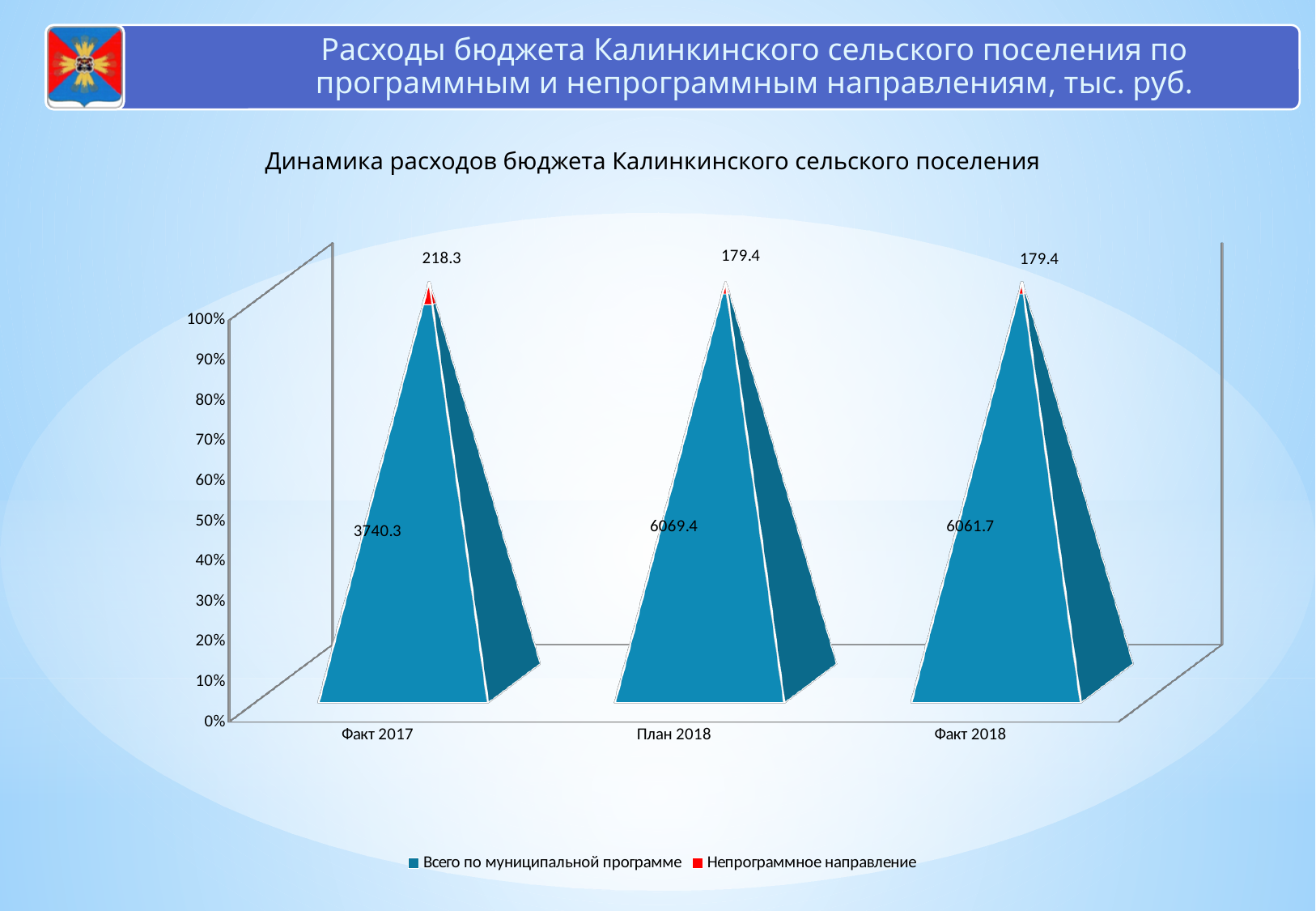
What is the value for Непрограммное направление for План 2018? 179.4 What is the value for Всего по муниципальной программе for Факт 2018? 6061.7 Which is larger: Всего по муниципальной программе for План 2018 or for Факт 2018? План 2018 What is the total of the two series for Факт 2017? 3958.6 Which category has the lowest value for Всего по муниципальной программе? Факт 2017 Which category has the highest value for Всего по муниципальной программе? План 2018 What is the difference between the Непрограммное направление values for Факт 2017 and Факт 2018? 38.9 What is the difference between the Всего по муниципальной программе values for План 2018 and Факт 2017? 2329.1 What is the value for Непрограммное направление for Факт 2017? 218.3 What is the value for Всего по муниципальной программе for Факт 2017? 3740.3 How many series does the legend list? 2 How many categories are shown on the x axis? 3